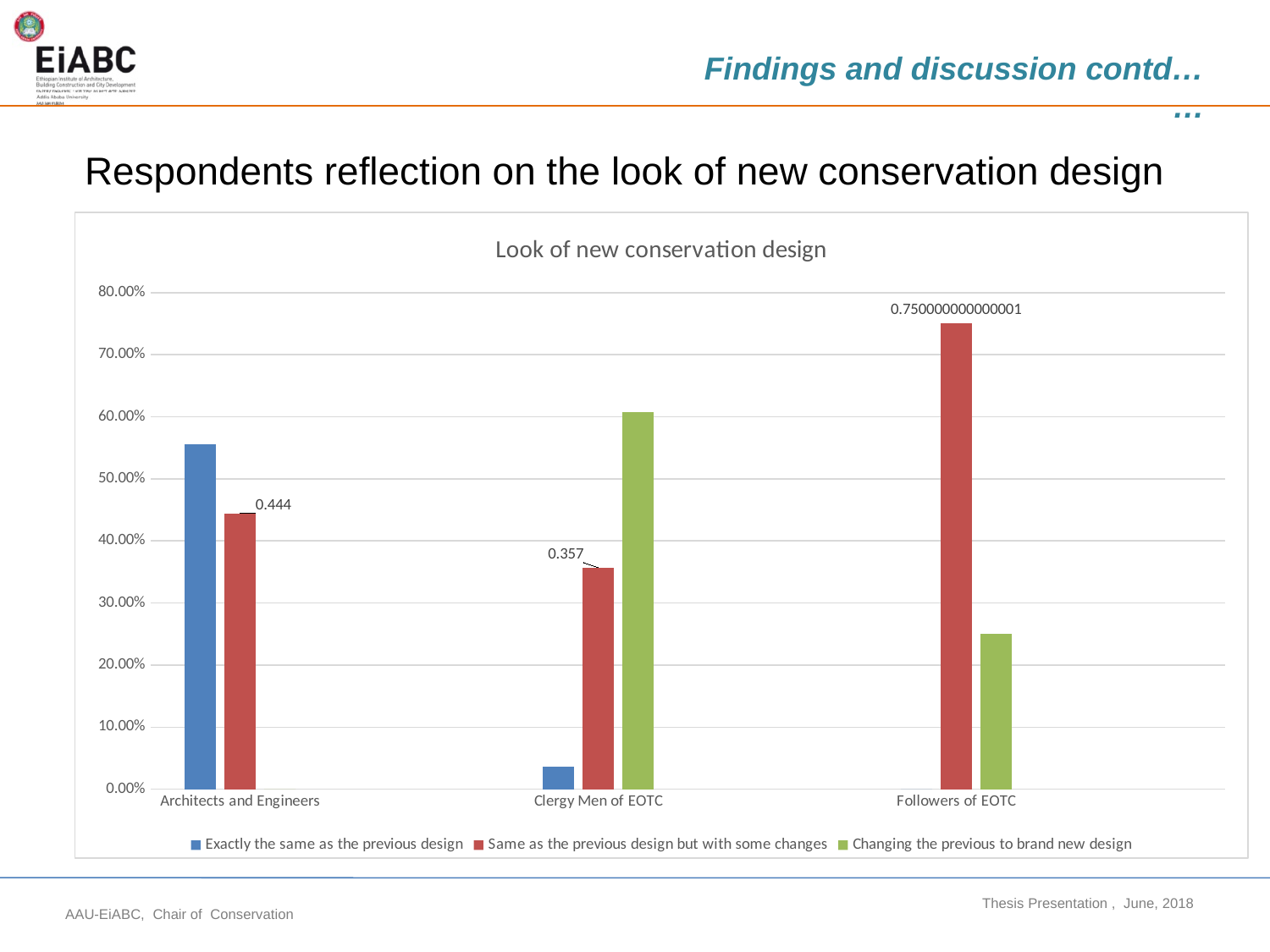
How many series does the legend list? 3 What is the data label on the 'Same as the previous design but with some changes' bar for Clergy Men of EOTC? 0.357 What is the data label on the 'Same as the previous design but with some changes' bar for Architects and Engineers? 0.444 What is the data label on the 'Same as the previous design but with some changes' bar for Followers of EOTC? 0.750000000000001 Is the value for 'Exactly the same as the previous design' for Architects and Engineers greater or less than 50.00%? greater What is the title of the chart? Look of new conservation design Which respondent group has the highest value for 'Same as the previous design but with some changes'? Followers of EOTC How many respondent groups are shown on the x axis? 3 For Followers of EOTC, which is larger: 'Same as the previous design but with some changes' or 'Changing the previous to brand new design'? Same as the previous design but with some changes Which respondent group has the lowest value for 'Same as the previous design but with some changes'? Clergy Men of EOTC What type of chart is shown on the slide? bar chart